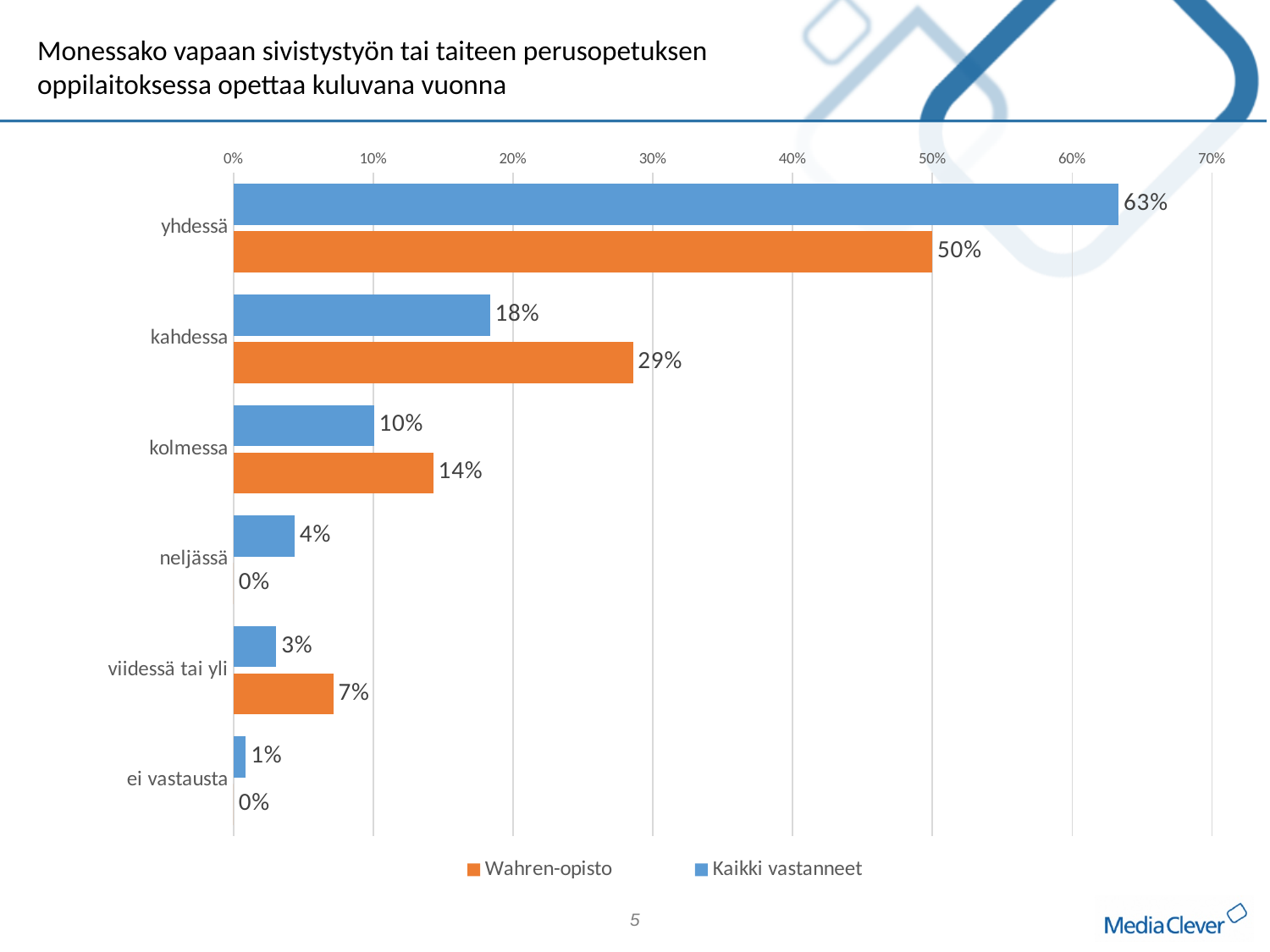
Which category has the highest value for Wahren-opisto? yhdessä What kind of chart is shown on the slide? bar chart Which colour represents Wahren-opisto in the chart? orange How many series does the legend list? 2 In the kolmessa category, which series has the larger value, Wahren-opisto or Kaikki vastanneet? Wahren-opisto What is the value for Wahren-opisto in the kahdessa category? 29% What is the value for Kaikki vastanneet in the yhdessä category? 63% What is the difference between Kaikki vastanneet and Wahren-opisto in the yhdessä category? 13% How many categories are shown on the chart? 6 Which category has the lowest value for Kaikki vastanneet? ei vastausta What is the value for Wahren-opisto in the neljässä category? 0% Is the value for Kaikki vastanneet in the kahdessa category greater or less than 20%? less